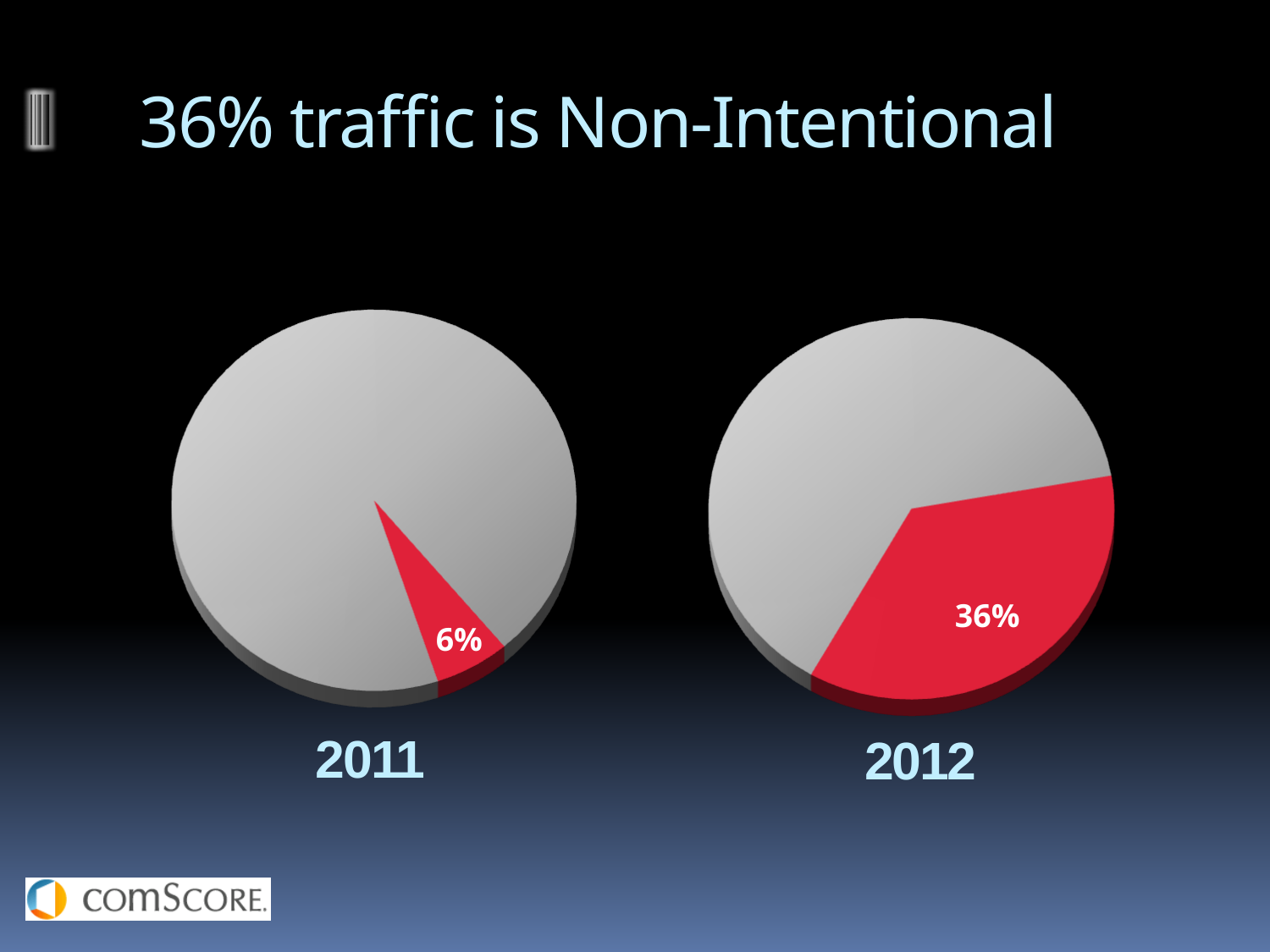
By how many percentage points did the red slice grow from the 2011 pie chart to the 2012 pie chart? 30 percentage points In the 2011 pie chart, what percentage is shown on the red slice? 6% What is the title of the slide above the pie charts? 36% traffic is Non-Intentional Which year's pie chart has the smaller red slice? 2011 Does the labelled red share rise or fall from the 2011 pie chart to the 2012 pie chart? Rises How many slices does each pie chart have? 2 Which pie chart has the larger red slice, 2011 or 2012? 2012 In the 2012 pie chart, what percentage is shown on the red slice? 36% What kind of charts are shown on the slide? Pie charts What share of the 2012 pie does the red slice represent? 36% What share of the 2011 pie does the red slice represent? 6% How many pie charts are on the slide? 2